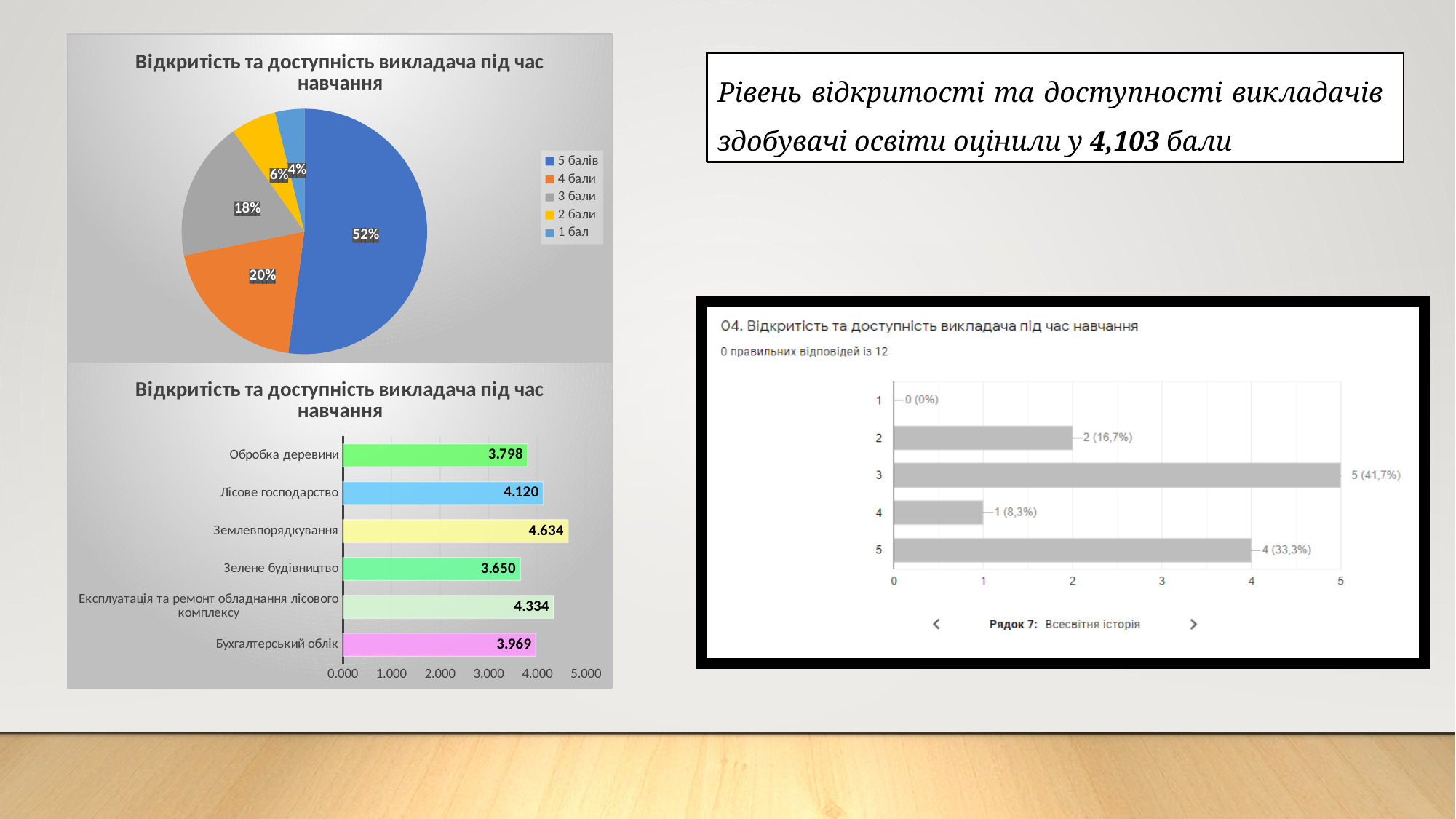
In the pie chart at the top left, what share of responses is '3 бали'? 18% In the bar chart at the bottom left, what is the difference between Лісове господарство and Обробка деревини? 0.322 How many categories are shown in the bar chart at the bottom left? 6 How many entries does the legend of the pie chart at the top left list? 5 In the pie chart at the top left, what share of responses is '5 балів'? 52% In the bar chart at the bottom left, which is larger: Експлуатація та ремонт обладнання лісового комплексу or Лісове господарство? Експлуатація та ремонт обладнання лісового комплексу In the pie chart at the top left, which category has the smallest slice? 1 бал In the chart on the right titled '04. Відкритість та доступність викладача під час навчання', how many responses does rating 3 have? 5 (41,7%) In the bar chart at the bottom left, what is the value for Землевпорядкування? 4.634 In the bar chart at the bottom left, which category has the lowest value? Зелене будівництво What type of chart is the chart on the right titled '04. Відкритість та доступність викладача під час навчання'? bar chart In the bar chart at the bottom left, what is the value for Бухгалтерський облік? 3.969